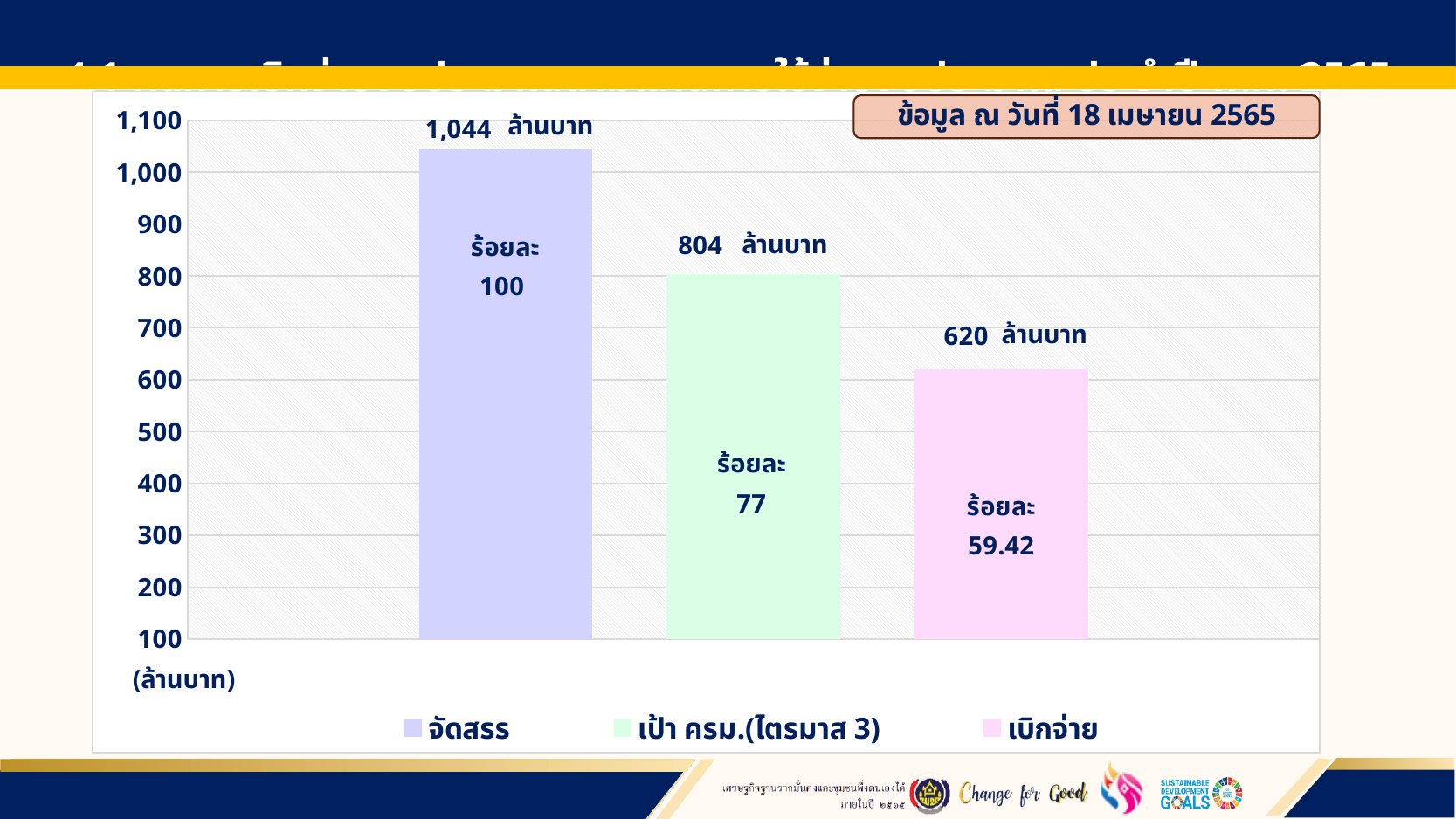
How many bars are plotted in the chart? 3 What percentage (ร้อยละ) is printed on the เบิกจ่าย bar? 59.42 Which category has the highest value? จัดสรร What is the value shown for เบิกจ่าย? 620 ล้านบาท Which is larger, the value for เป้า ครม.(ไตรมาส 3) or the value for เบิกจ่าย? เป้า ครม.(ไตรมาส 3) Which category has the lowest value? เบิกจ่าย What percentage (ร้อยละ) is printed on the เป้า ครม.(ไตรมาส 3) bar? 77 What is the value shown for จัดสรร? 1,044 ล้านบาท What is the difference between the จัดสรร value and the เบิกจ่าย value? 424 ล้านบาท What is the value shown for เป้า ครม.(ไตรมาส 3)? 804 ล้านบาท What is the difference between the เป้า ครม.(ไตรมาส 3) value and the เบิกจ่าย value? 184 ล้านบาท What kind of chart is shown on the slide? Bar chart